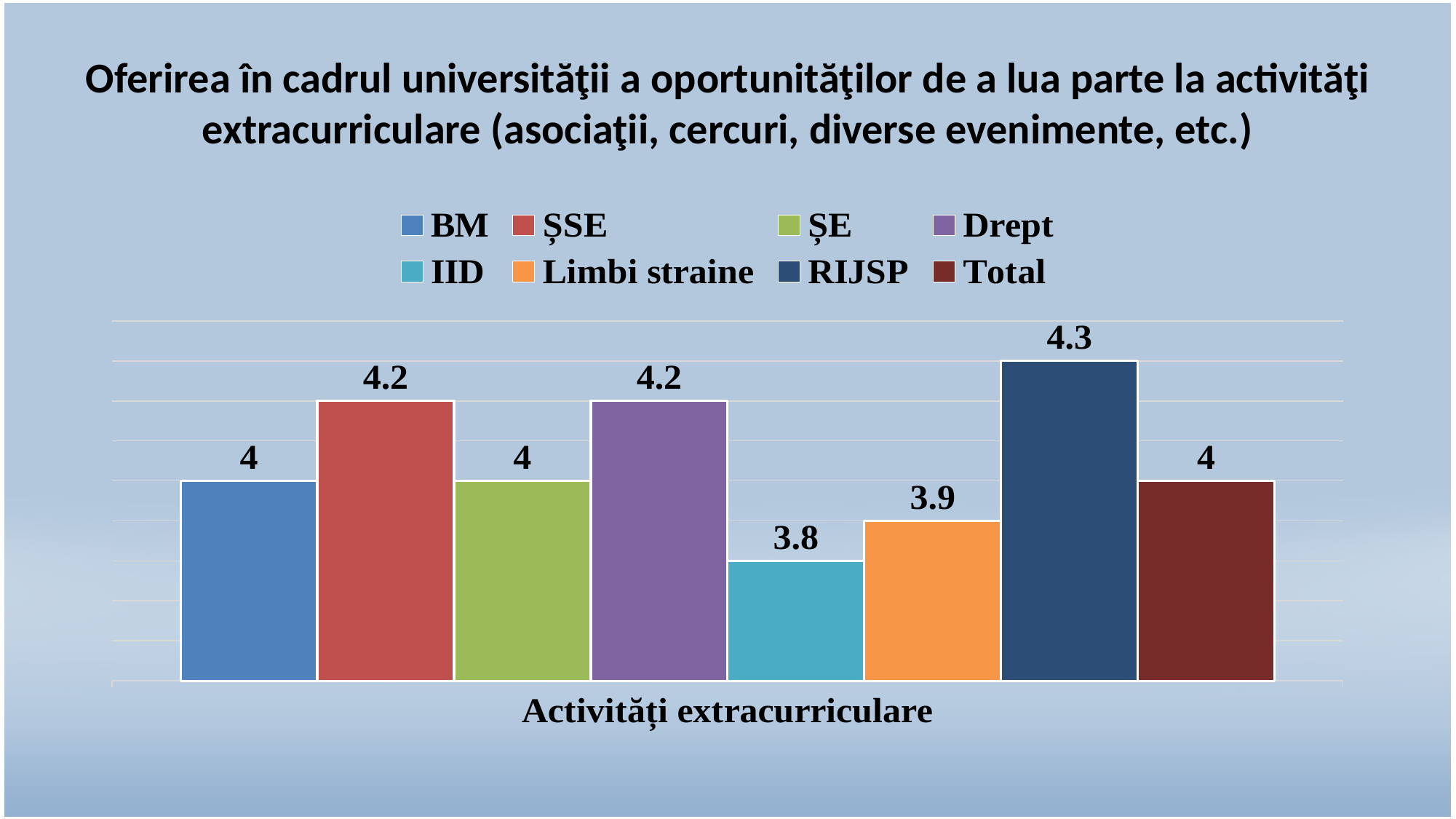
What is the label on the x axis of the chart? Activități extracurriculare What is the difference between the values for RIJSP and IID? 0.5 Which series has the highest value? RIJSP How many series does the legend list? 8 What kind of chart is shown on the slide? Bar chart Which is larger, the value for Drept or the value for IID? Drept What is the value for RIJSP? 4.3 What is the value for IID? 3.8 What is the difference between the values for ȘSE and Limbi straine? 0.3 What is the value for Limbi straine? 3.9 What is the value for Total? 4 Which series has the lowest value? IID